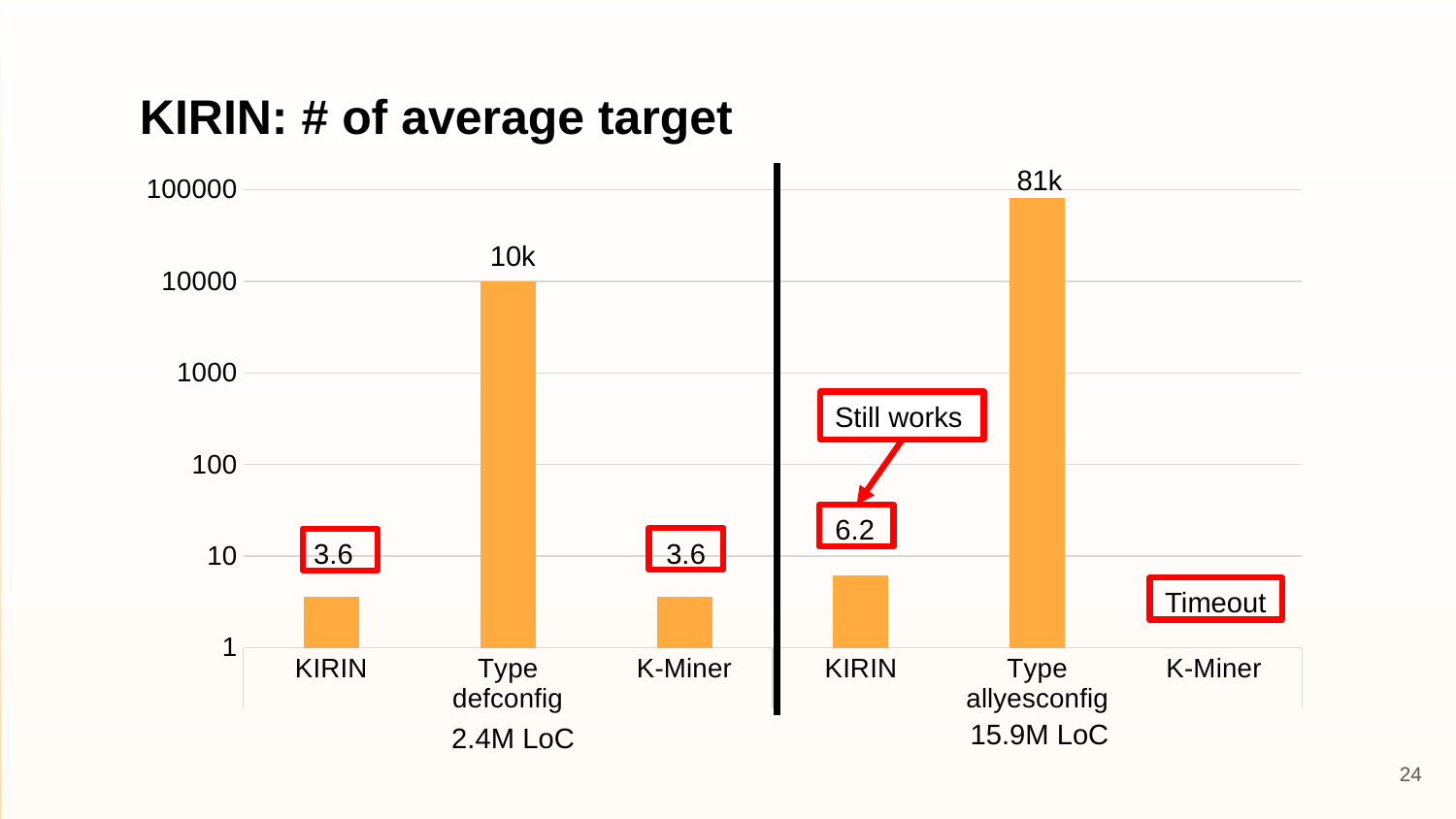
What is the value for Type under allyesconfig (15.9M LoC)? 81k Which bar has the highest value on the chart? Type allyesconfig Is the value for KIRIN under allyesconfig greater or less than 10? less What is shown for K-Miner under allyesconfig (15.9M LoC)? Timeout What is the value for KIRIN under defconfig (2.4M LoC)? 3.6 What is the value for K-Miner under defconfig (2.4M LoC)? 3.6 Is the value for Type under defconfig greater or less than 1000? greater What is the value for KIRIN under allyesconfig (15.9M LoC)? 6.2 What is the value for Type under defconfig (2.4M LoC)? 10k What is the title of the chart? KIRIN: # of average target Which is larger, the value for KIRIN under defconfig or the value for KIRIN under allyesconfig? KIRIN under allyesconfig What type of chart is shown on the slide? bar chart